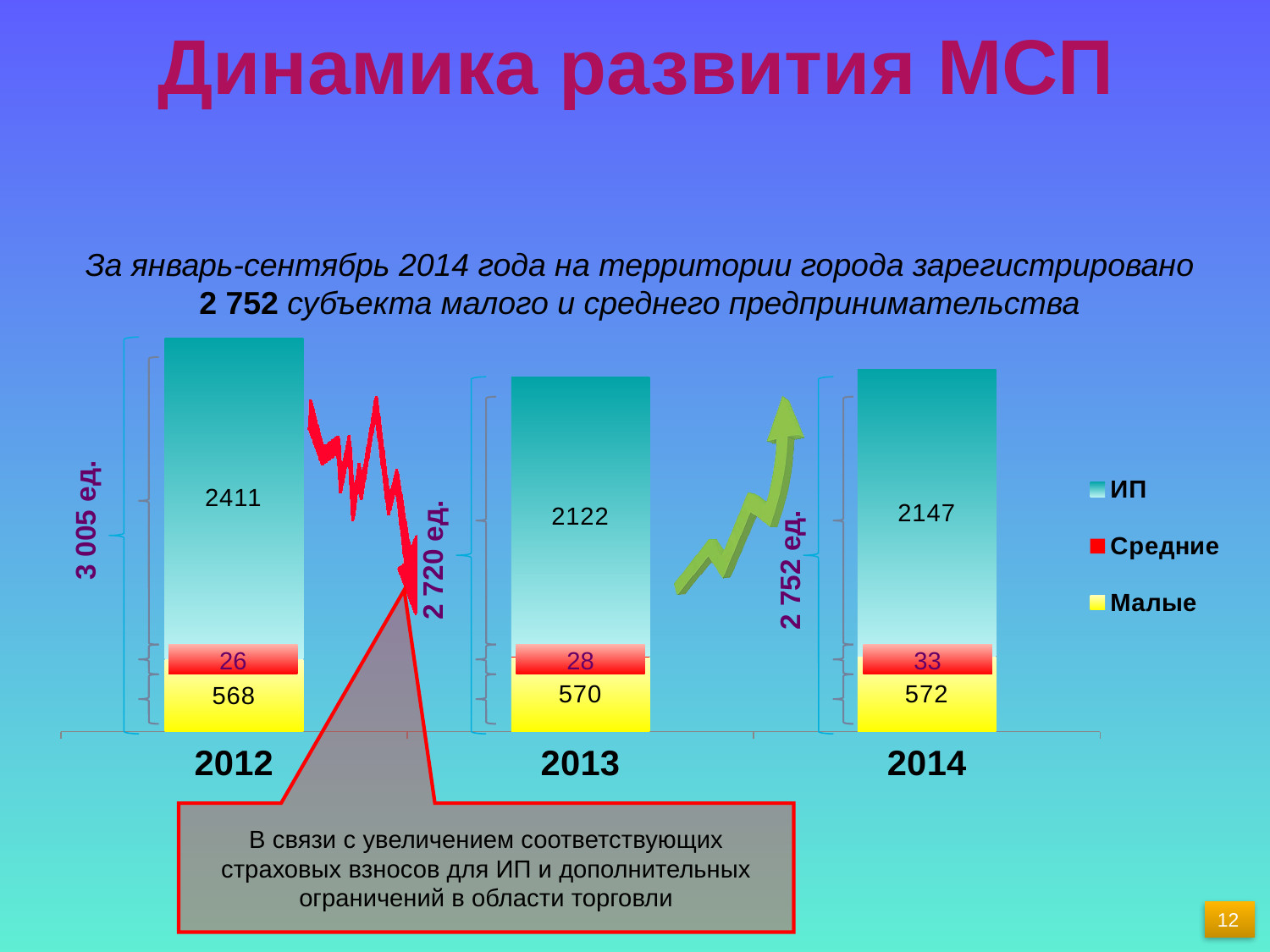
Which year has the highest value for ИП? 2012 What is the total of the stacked bar for 2014? 2 752 Which year has the lowest value for Средние? 2012 How many years are shown on the x axis? 3 What is the value for ИП in 2012? 2411 What is the value for Малые in 2013? 570 How many series does the legend list? 3 Which colour represents Малые in the legend? yellow Which is larger, the Малые value for 2014 or for 2012? 2014 What kind of chart is shown on the slide? stacked bar chart What is the difference between the ИП values for 2012 and 2013? 289 What is the value for Средние in 2014? 33